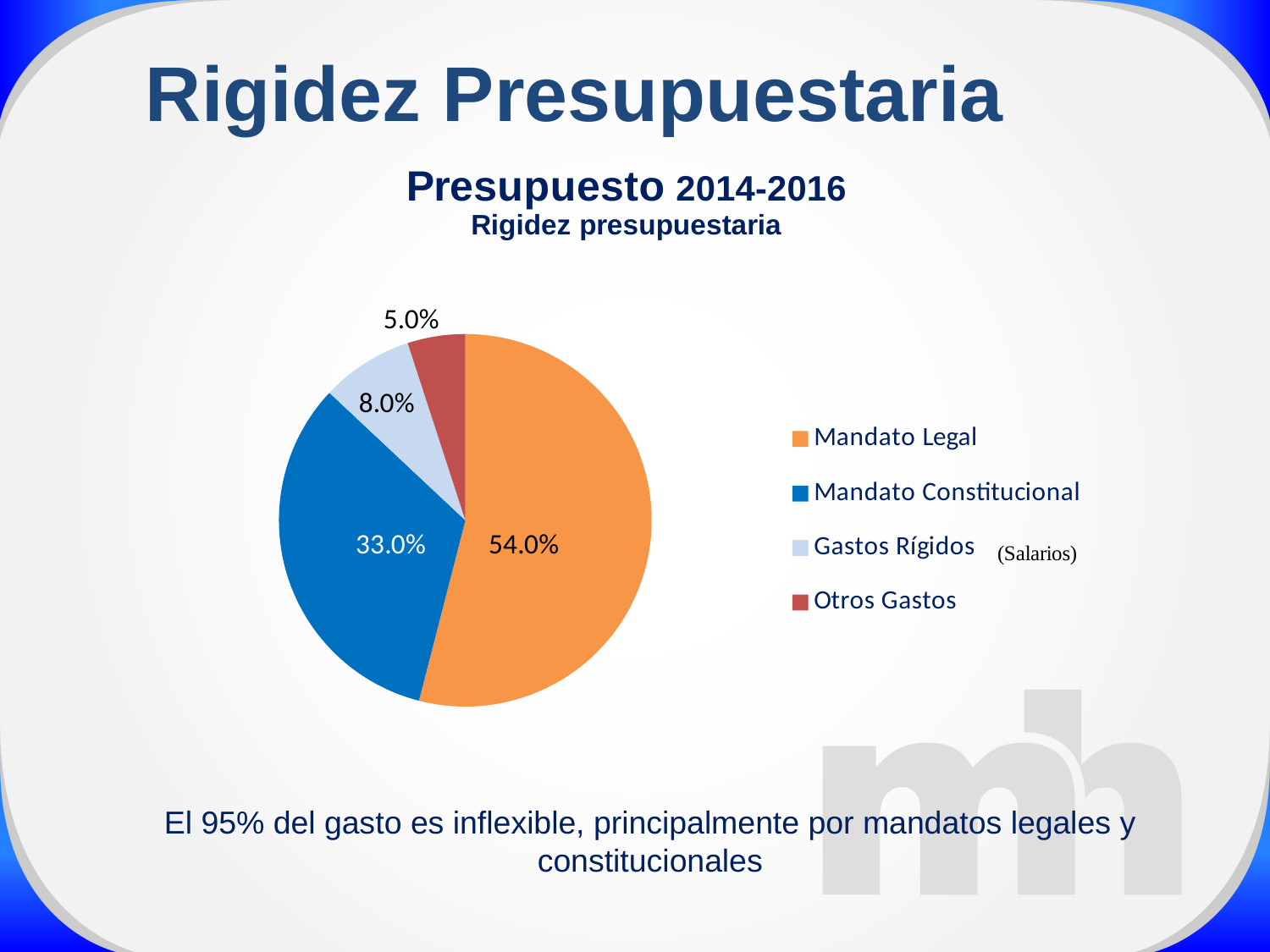
What is the title of the chart? Presupuesto 2014-2016 Rigidez presupuestaria How many entries does the legend list? 4 Which category has the largest slice of the pie? Mandato Legal What kind of chart is shown on the slide? pie chart What share of the pie does Gastos Rígidos represent? 8.0% What share of the pie does Mandato Legal represent? 54.0% Which is larger, the share for Gastos Rígidos or the share for Otros Gastos? Gastos Rígidos What share of the pie does Mandato Constitucional represent? 33.0% What is the difference between the Mandato Legal and Mandato Constitucional shares? 21.0% What share of the pie does Otros Gastos represent? 5.0% Which category has the smallest slice of the pie? Otros Gastos How many slices does the pie chart have? 4